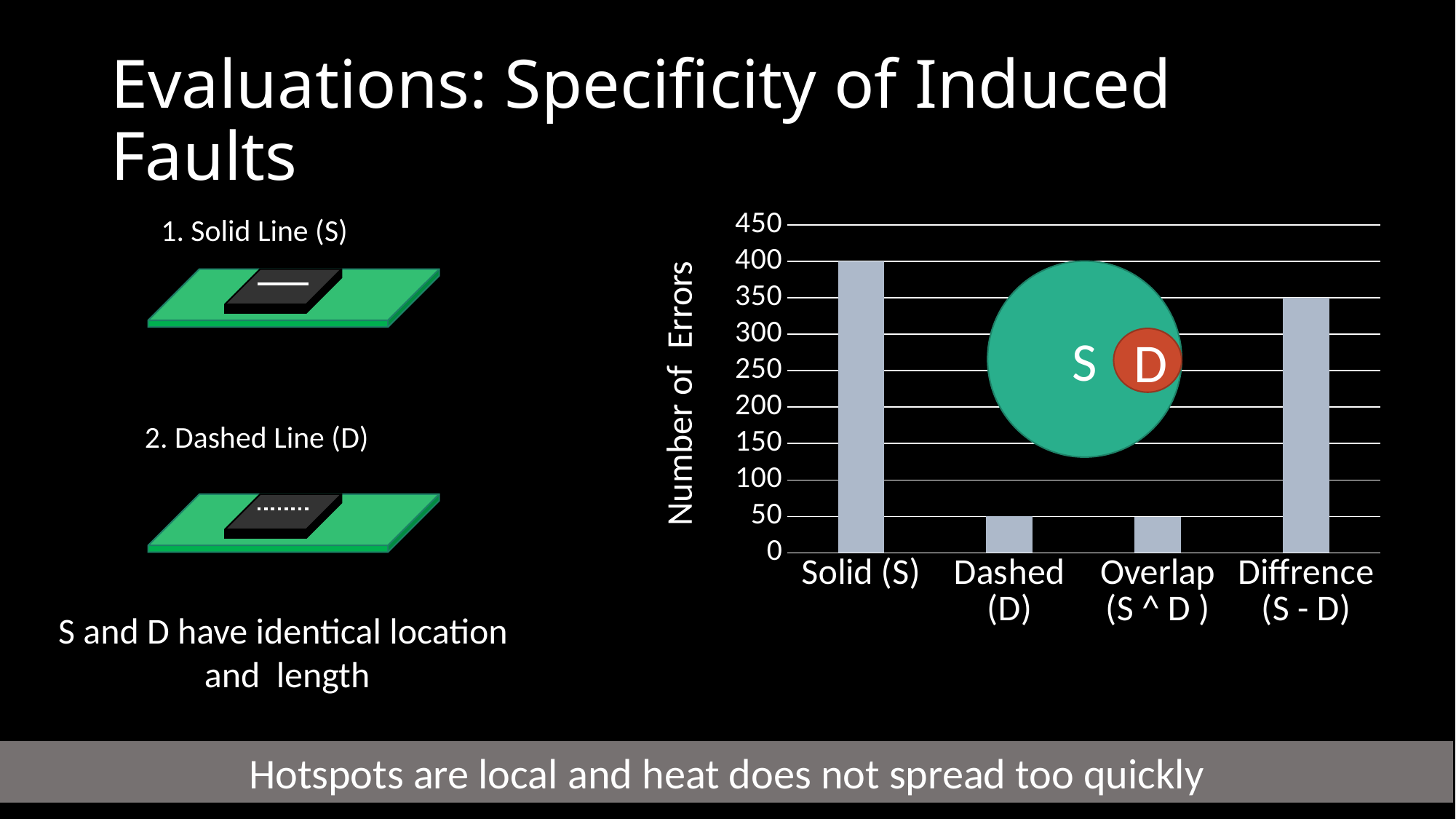
What is the label of the y axis of the chart? Number of Errors Is the value for Overlap (S ^ D) greater or less than 100? less What is the number of errors for Dashed (D)? 50 What is the number of errors for Solid (S)? 400 What type of chart is shown on the slide? bar chart What is the number of errors for Diffrence (S - D)? 350 Is the value for Diffrence (S - D) greater or less than 300? greater How many categories are shown on the x axis of the chart? 4 Which category has the highest number of errors? Solid (S) Which has more errors, Solid (S) or Diffrence (S - D)? Solid (S) What is the difference in number of errors between Solid (S) and Dashed (D)? 350